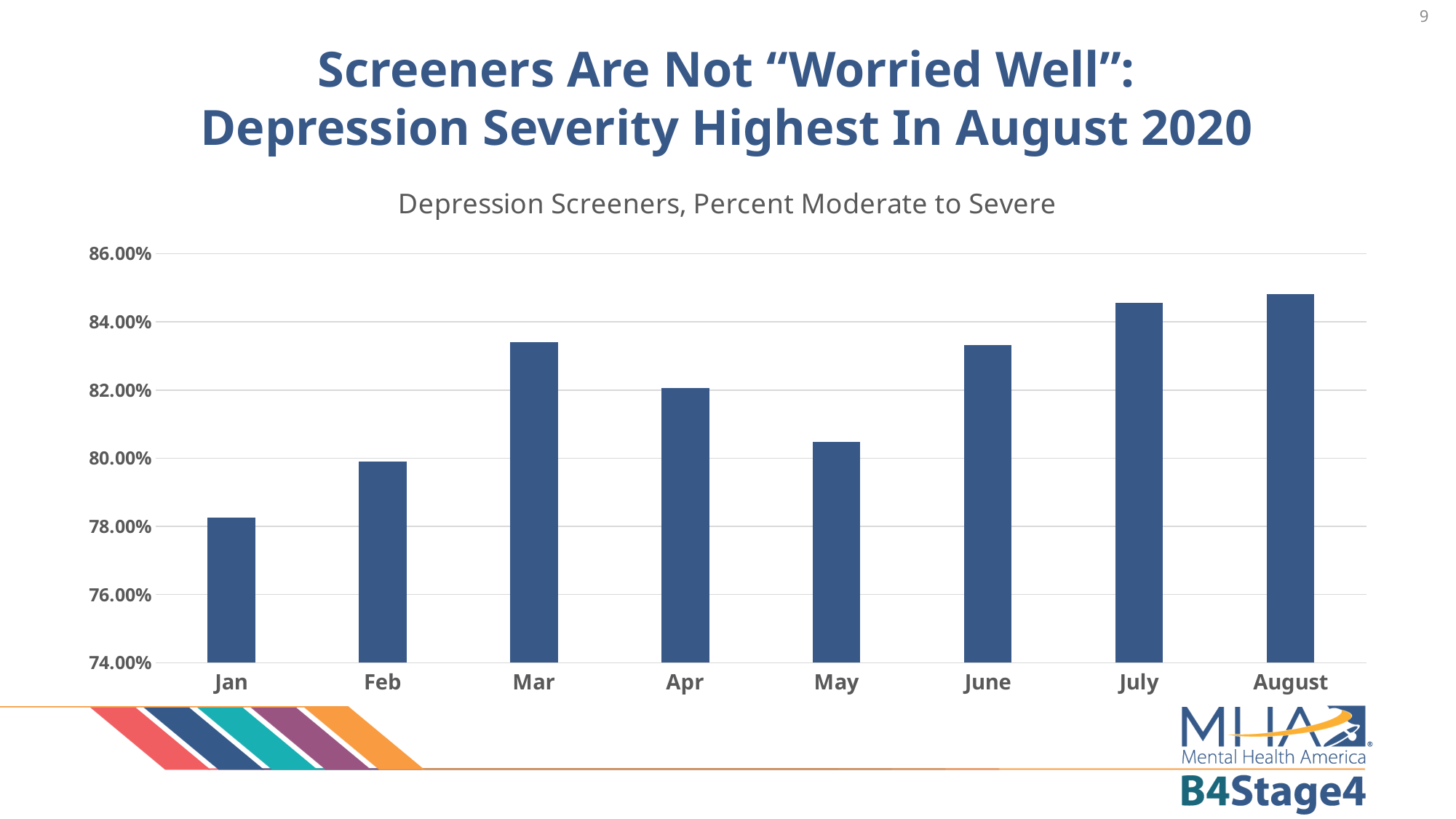
What is the title of the chart? Depression Screeners, Percent Moderate to Severe Is the value for Mar greater or less than 82.00%? greater Is the value for May greater or less than 82.00%? less Is the value for Jan greater or less than 80.00%? less How many months are plotted on the chart? 8 Which month has the highest percent moderate to severe? August What type of chart is shown on the slide? Bar chart Which is larger, the value for Feb or the value for May? May Overall, do the values rise or fall from Jan to August? Rise Which month has the lowest percent moderate to severe? Jan Which is larger, the value for Mar or the value for Apr? Mar